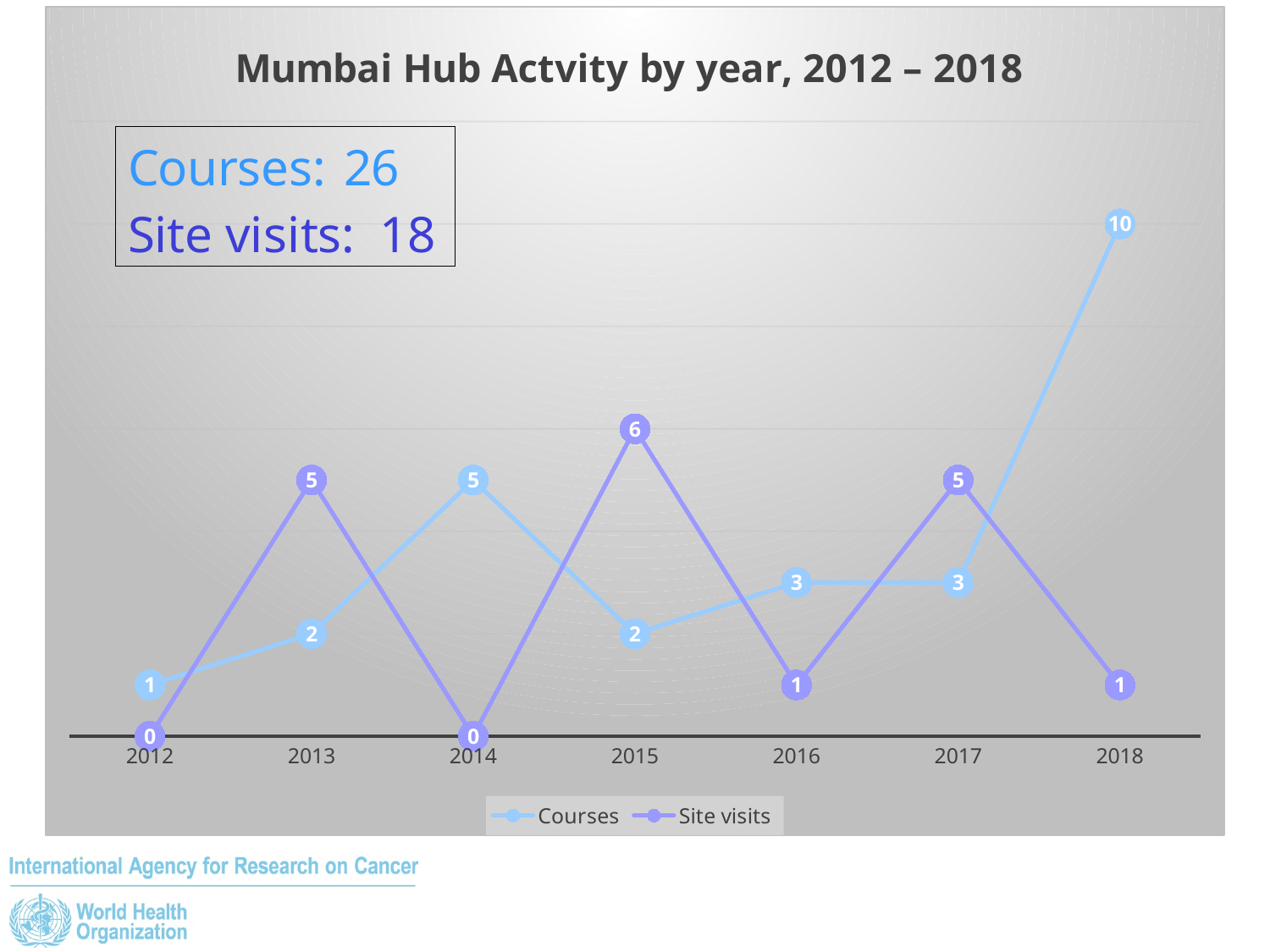
What is the value for Courses in 2018? 10 What is the title of the chart? Mumbai Hub Actvity by year, 2012 – 2018 Which series has the larger value in 2013, Courses or Site visits? Site visits How many series does the legend list? 2 What kind of chart is shown on the slide? line chart In which year is the Courses value highest? 2018 What is the value for Courses in 2014? 5 What is the value for Site visits in 2015? 6 In which year is the Site visits value highest? 2015 In which year is the Courses value lowest? 2012 What is the difference between Courses and Site visits in 2018? 9 How many years are plotted along the x axis? 7